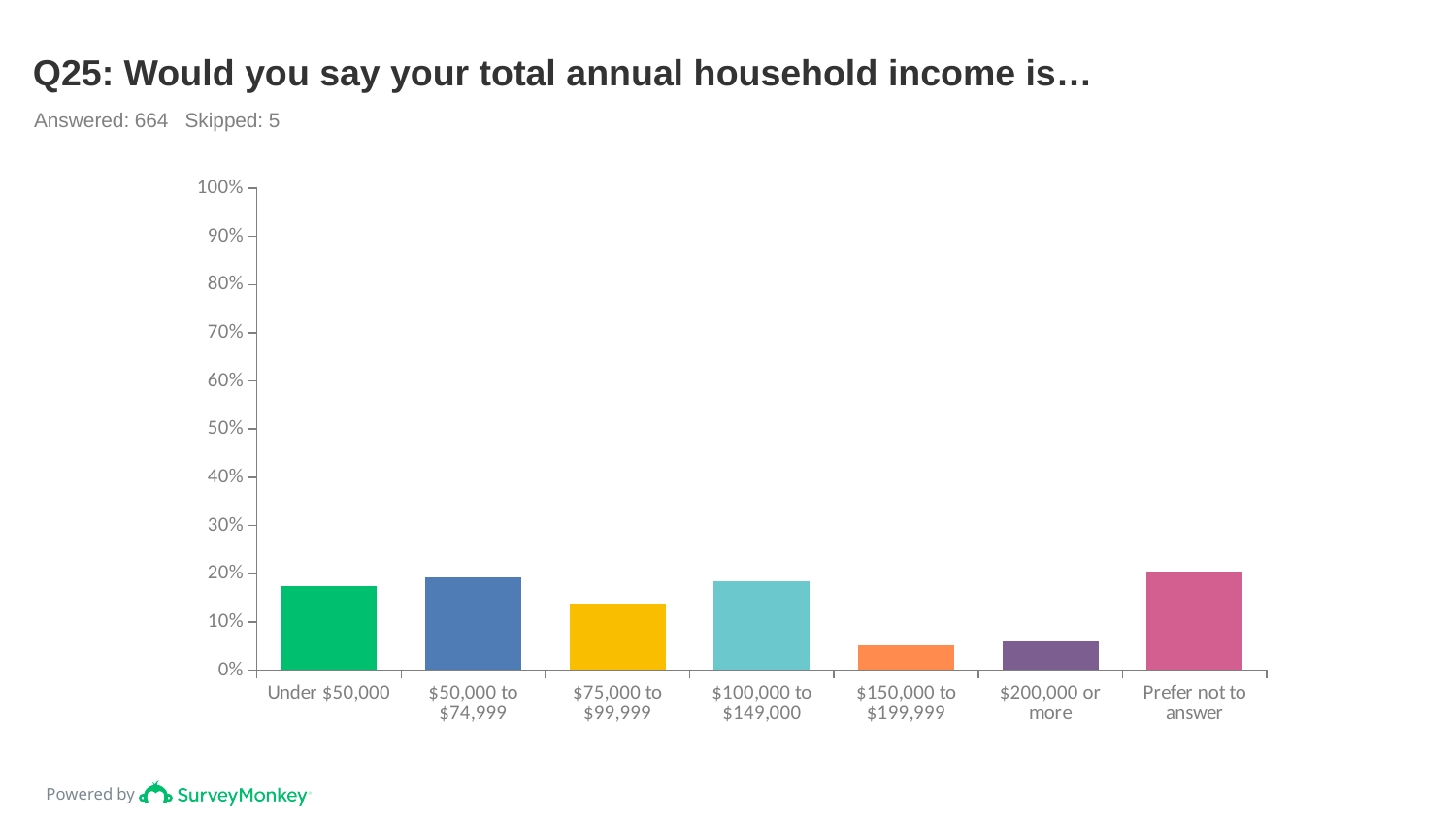
Is the value for $75,000 to $99,999 greater or less than 20%? less What kind of chart is shown on the slide? bar chart How many income categories are shown on the x axis? 7 What is the title of the chart? Q25: Would you say your total annual household income is… Is the value for Prefer not to answer greater or less than 10%? greater Is the value for $200,000 or more greater or less than 10%? less Which is larger, the value for $50,000 to $74,999 or the value for $75,000 to $99,999? $50,000 to $74,999 Which is larger, the value for Prefer not to answer or the value for $200,000 or more? Prefer not to answer How many respondents answered the question according to the slide? 664 Which is larger, the value for Under $50,000 or the value for $150,000 to $199,999? Under $50,000